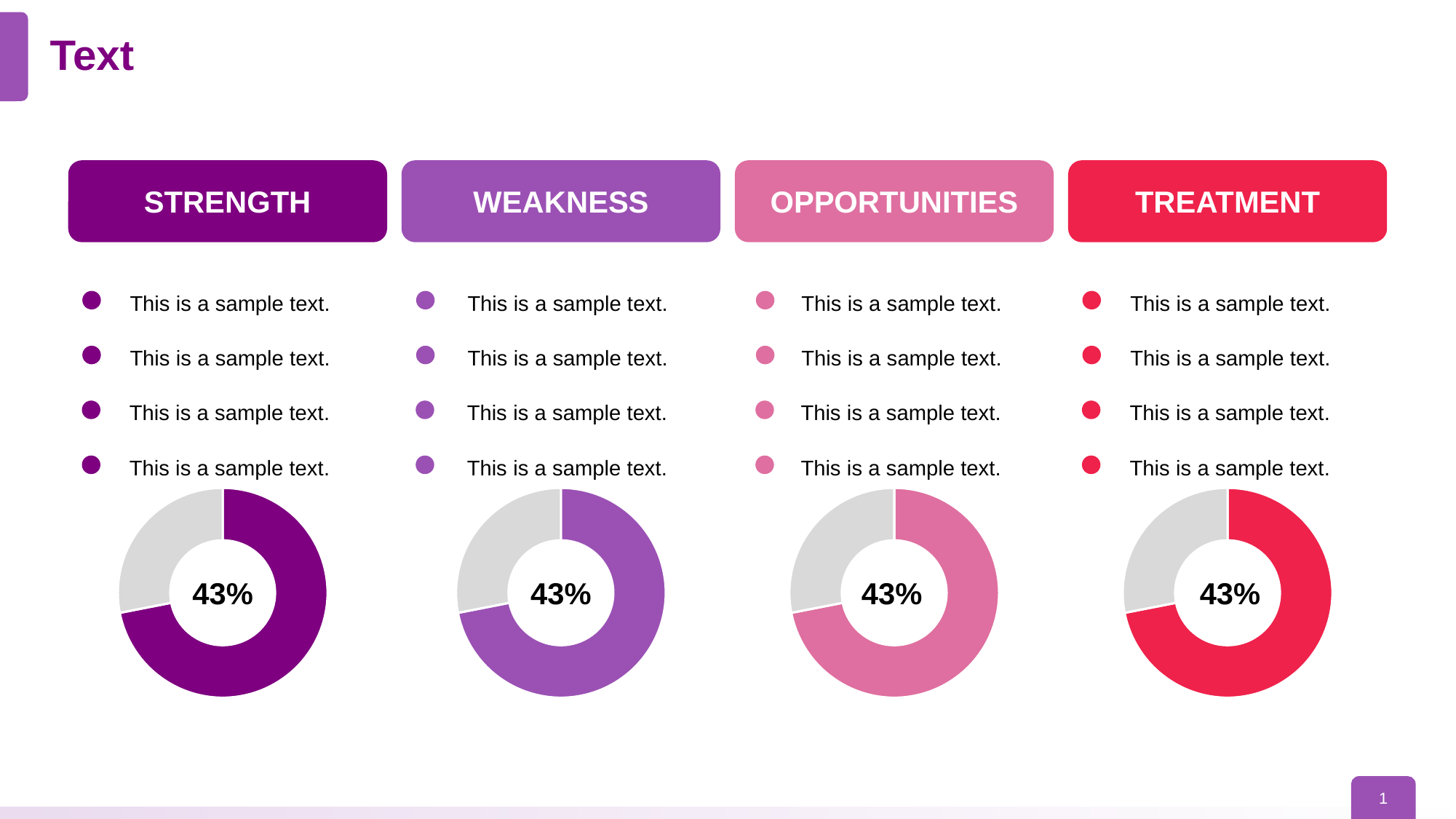
What percentage is shown in the centre of the STRENGTH donut chart? 43% Is the percentage printed in the STRENGTH donut chart greater or less than 50%? less How many donut charts are on the slide? 4 What colour is the filled portion of the TREATMENT donut chart? Red Do the STRENGTH and WEAKNESS donut charts show the same printed percentage? Yes, both show 43% What percentage is shown in the centre of the WEAKNESS donut chart? 43% What percentage is shown in the centre of the OPPORTUNITIES donut chart? 43% Which heading sits above the pink donut chart? OPPORTUNITIES What percentage is shown in the centre of the TREATMENT donut chart? 43% What kind of chart is used under each of the four headings on the slide? Donut chart Is the percentage printed in the TREATMENT donut chart greater or less than 40%? greater